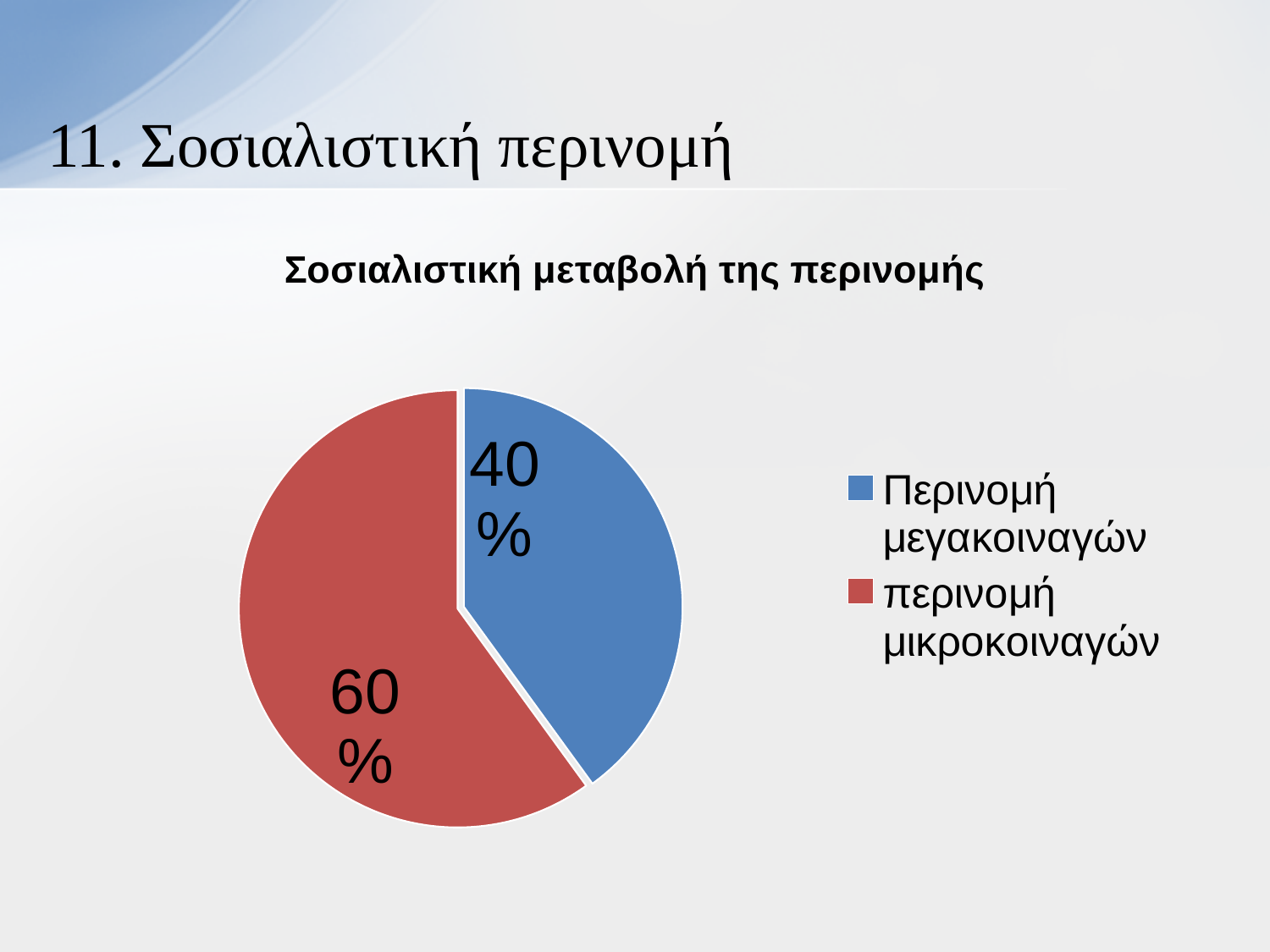
What colour is the slice for Περινομή μεγακοιναγών? blue What is the title of the chart? Σοσιαλιστική μεταβολή της περινομής How many slices does the pie chart have? 2 What is the difference in percentage points between περινομή μικροκοιναγών and Περινομή μεγακοιναγών? 20 percentage points Which is larger, Περινομή μεγακοιναγών or περινομή μικροκοιναγών? περινομή μικροκοιναγών What kind of chart is shown on the slide? pie chart Which slice is the smallest? Περινομή μεγακοιναγών Which slice is the largest? περινομή μικροκοιναγών What share of the pie does Περινομή μεγακοιναγών have? 40% What share of the pie does περινομή μικροκοιναγών have? 60% How many entries does the legend list? 2